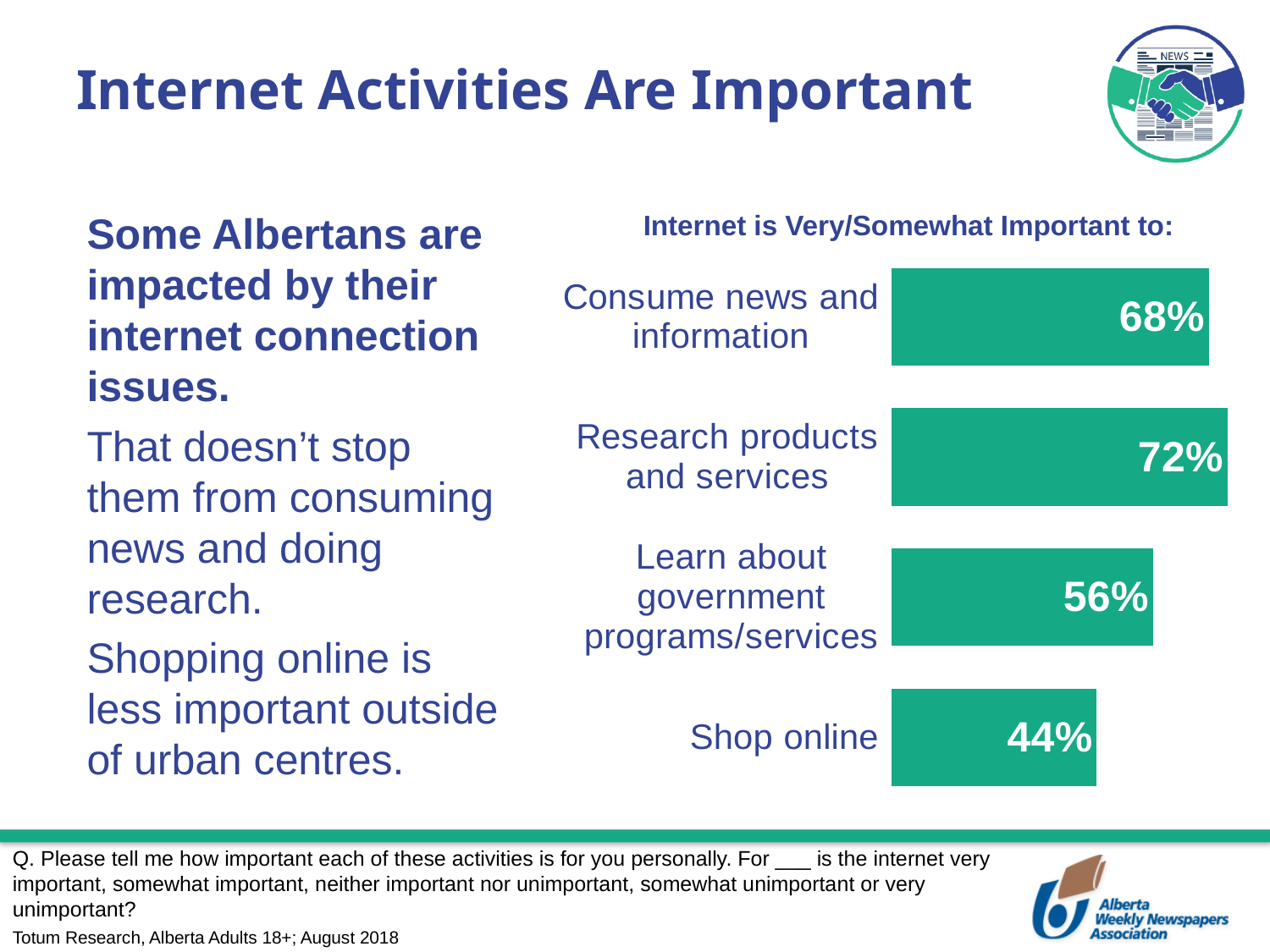
What is the value for Learn about government programs/services? 56% What is the title of the chart? Internet is Very/Somewhat Important to: What kind of chart is shown on the slide? Bar chart What is the difference between the values for Consume news and information and Learn about government programs/services? 12% Which activity has the lowest percentage? Shop online Which activity has the highest percentage? Research products and services What is the difference between the values for Research products and services and Shop online? 28% What is the value for Shop online? 44% What is the value for Research products and services? 72% How many activities are shown in the chart? 4 What percentage say the internet is very/somewhat important to consume news and information? 68% Which is larger: the value for Consume news and information or the value for Research products and services? Research products and services